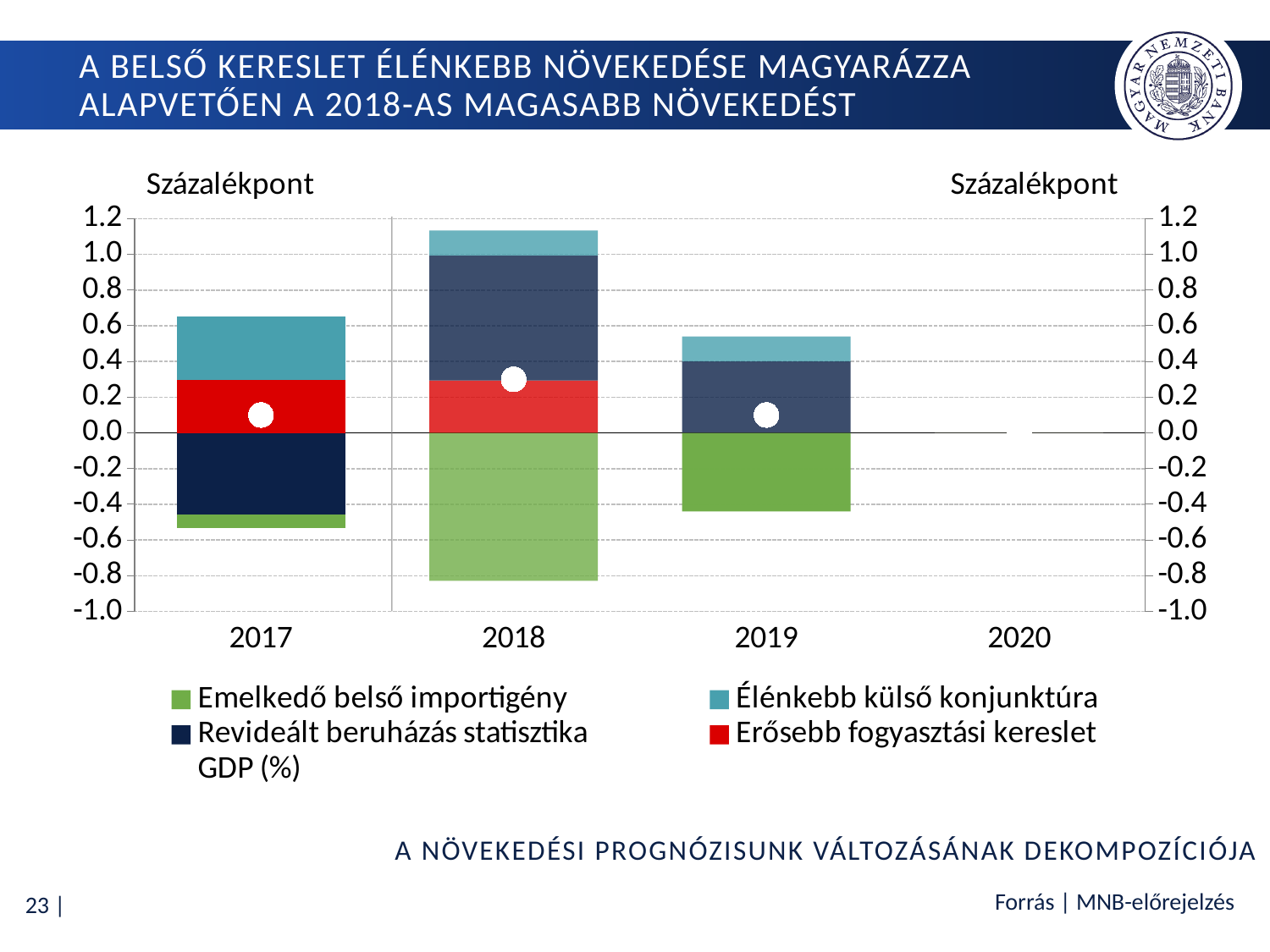
What is the label shown on the vertical axes? Százalékpont How many series does the legend list? 5 What kind of chart is shown on the slide? Stacked bar chart Which colour represents 'Erősebb fogyasztási kereslet' in the legend? Red Is the bottom of the negative stacked bar for 2017 greater or less than -0.4? less Is the bottom of the negative stacked bar for 2018 greater or less than -0.6? less Which year has the tallest positive stacked bar? 2018 How many years are labelled on the x axis? 4 Is the top of the positive stacked bar for 2019 greater or less than 0.4? greater Which year has the negative part of the bar extending furthest below zero? 2018 Which year has a larger positive stacked bar, 2017 or 2019? 2017